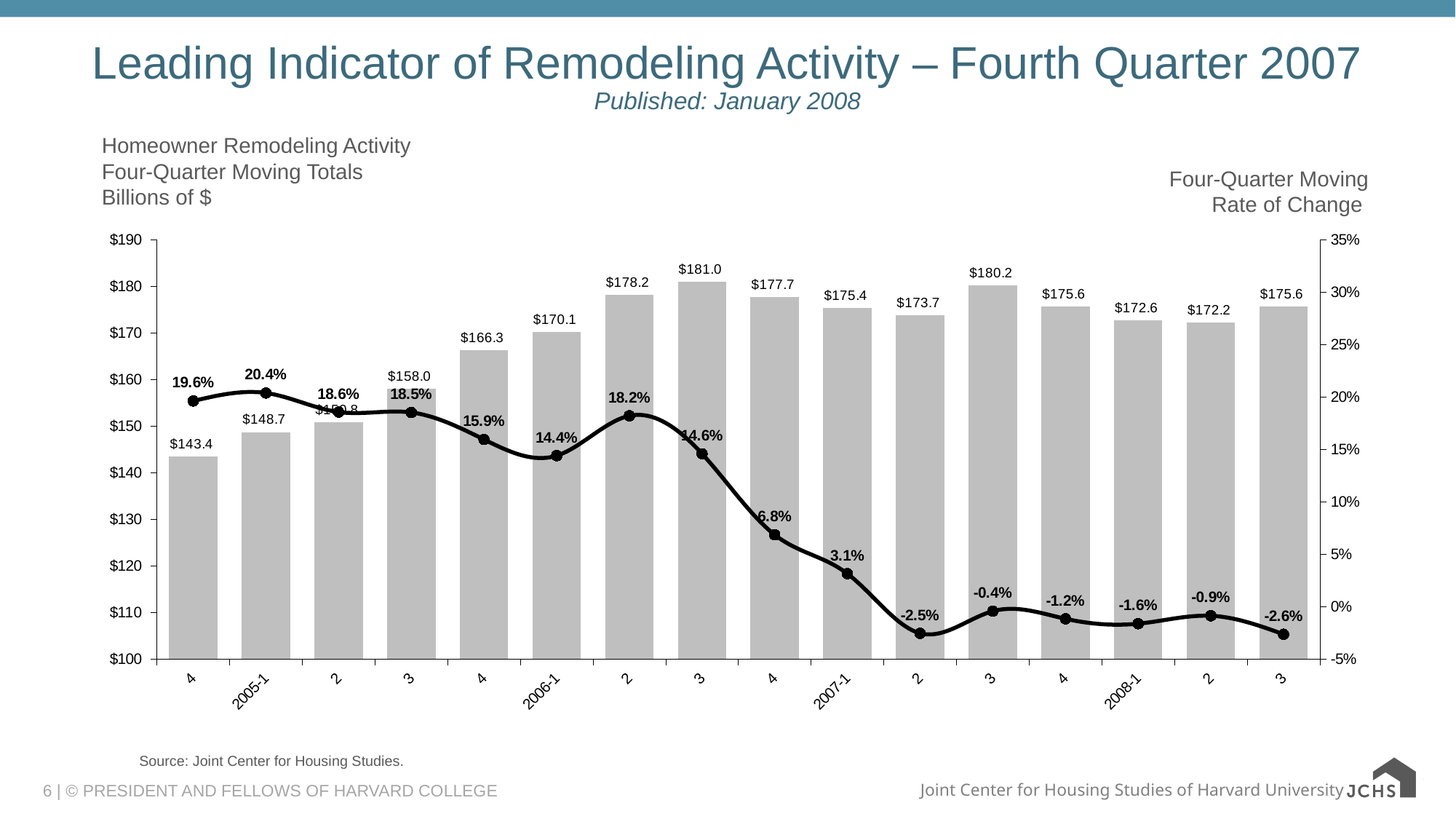
Which is larger, the four-quarter moving total for 2007-3 or for 2008-1? 2007-3 ($180.2) Which quarter has the highest four-quarter moving rate of change on the line? 2005-1 (20.4%) What is the four-quarter moving rate of change for 2007-1? 3.1% How many quarters are shown along the x axis of the chart? 16 Is the four-quarter moving total for 2005-1 greater or less than $150? less What is the four-quarter moving total of homeowner remodeling activity for 2006-1? $170.1 Which quarter has the highest four-quarter moving total (bar) on the chart? 2006-3 ($181.0) Which quarter has the lowest four-quarter moving rate of change on the line? 2008-3 (-2.6%) What is the unit of the left-hand axis of the chart? Billions of $ What is the difference between the four-quarter moving totals for 2006-3 and 2007-1? $5.6 Does the four-quarter moving rate of change generally rise or fall from 2006-2 to 2007-2? fall What kind of chart is shown on the slide? A combination bar and line chart